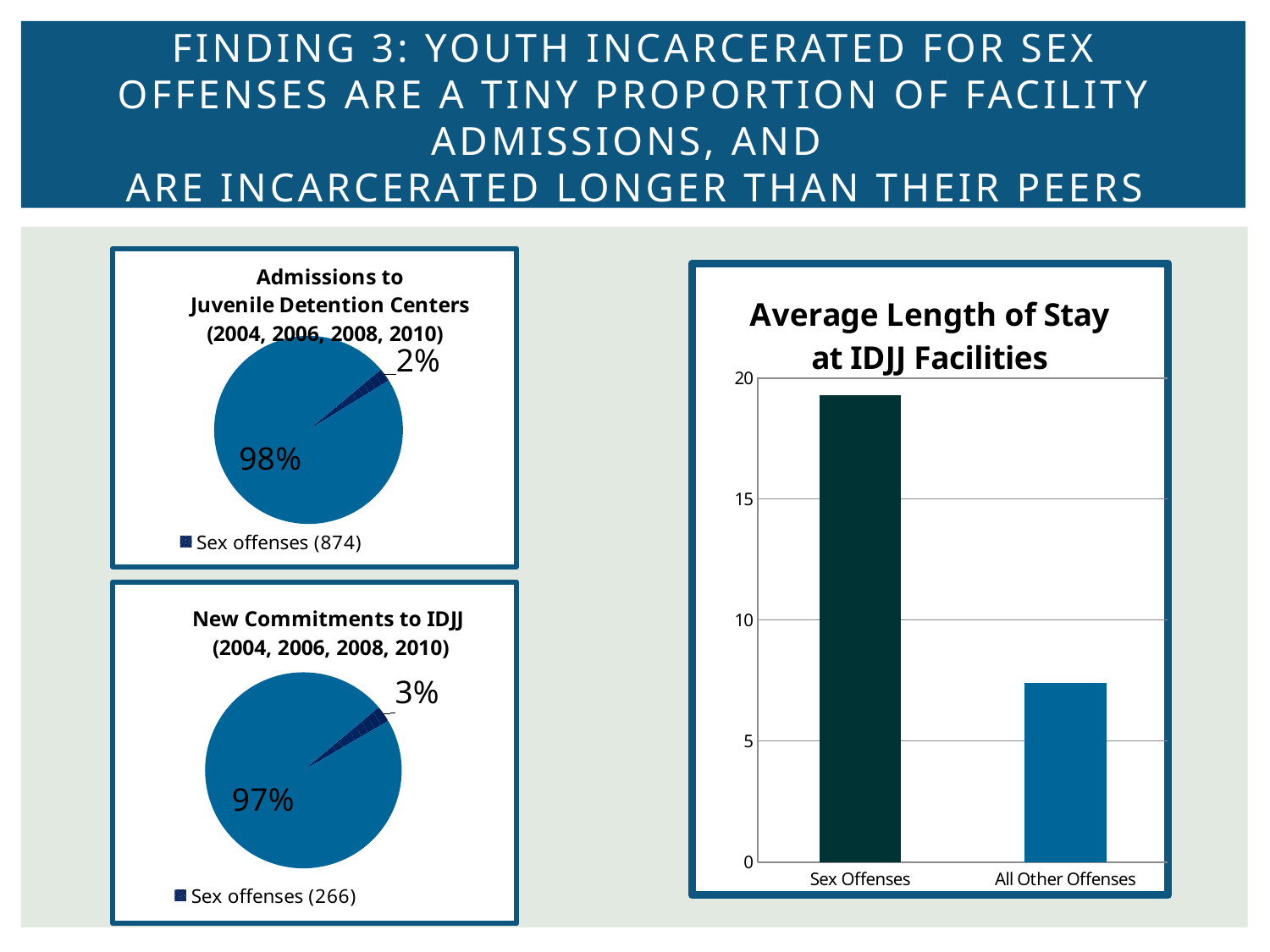
In the 'New Commitments to IDJJ' pie chart, what share of the pie is labelled for sex offenses? 3% In the 'Admissions to Juvenile Detention Centers' pie chart, what share of the pie is labelled for sex offenses? 2% In the 'Average Length of Stay at IDJJ Facilities' chart, is the value for All Other Offenses greater or less than 10? less In the 'Average Length of Stay at IDJJ Facilities' chart, what kind of chart is shown? bar chart In the 'Average Length of Stay at IDJJ Facilities' chart, which category has the highest value? Sex Offenses In the 'Average Length of Stay at IDJJ Facilities' chart, which is larger, the value for Sex Offenses or the value for All Other Offenses? Sex Offenses In the 'New Commitments to IDJJ' pie chart, what does the legend entry say? Sex offenses (266) In the 'Average Length of Stay at IDJJ Facilities' chart, which category has the lowest value? All Other Offenses In the 'New Commitments to IDJJ' pie chart, what percentage is shown on the large slice? 97% In the 'Admissions to Juvenile Detention Centers' pie chart, what percentage is shown on the large slice? 98% In the 'Average Length of Stay at IDJJ Facilities' chart, is the value for Sex Offenses greater or less than 15? greater In the 'Average Length of Stay at IDJJ Facilities' chart, how many categories are shown on the x axis? 2